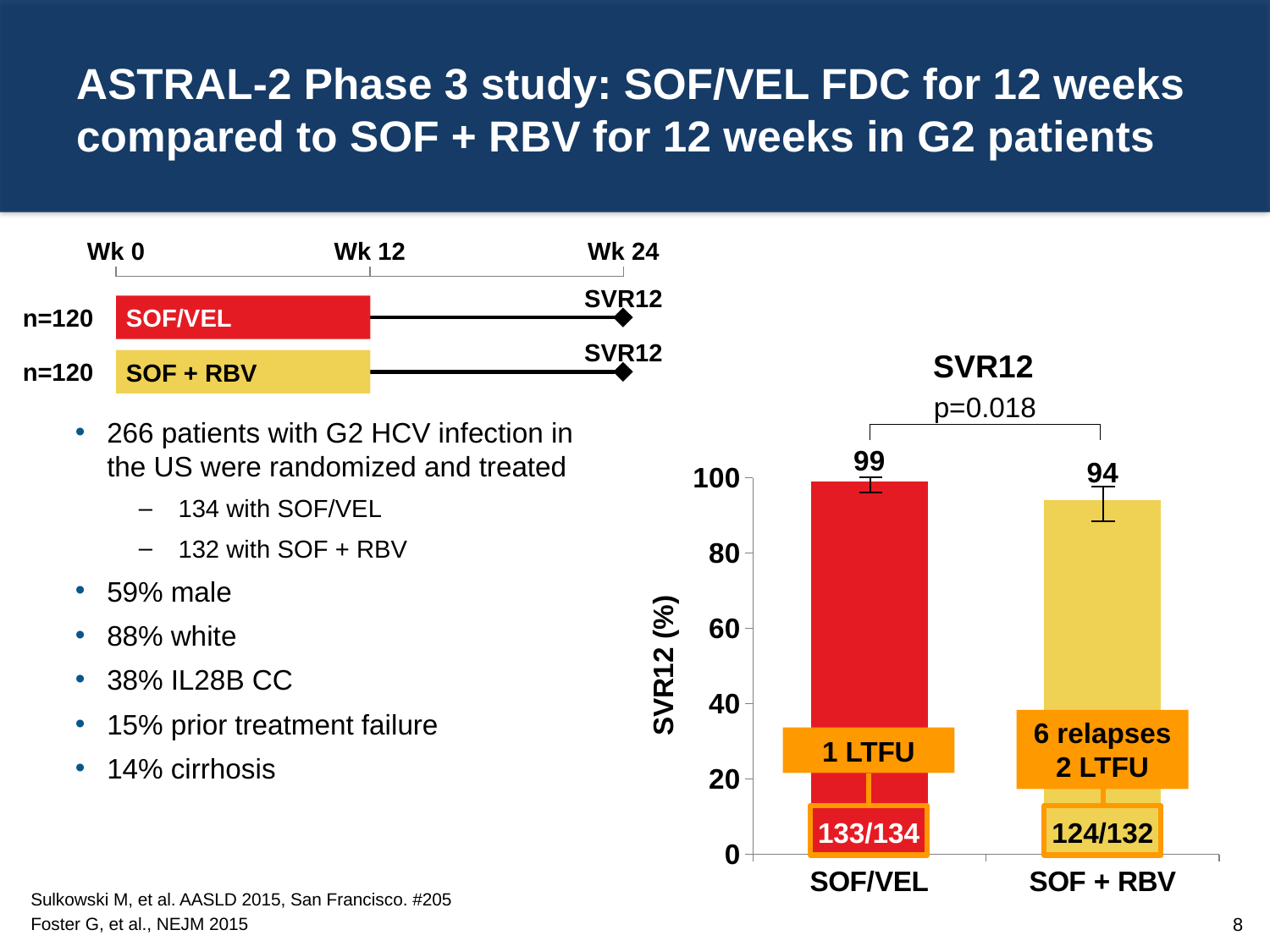
What is the SVR12 value for SOF + RBV? 94 What is the y-axis label of the chart? SVR12 (%) What kind of chart is shown on the slide? Bar chart Which treatment arm has the higher SVR12? SOF/VEL What is the difference in SVR12 between SOF/VEL and SOF + RBV? 5 Which treatment arm has the lower SVR12? SOF + RBV What is the SVR12 value for SOF/VEL? 99 What fraction of patients achieved SVR12 in the SOF + RBV arm? 124/132 What is the title of the chart? SVR12 Is the SVR12 for SOF + RBV greater or less than 80? greater What fraction of patients achieved SVR12 in the SOF/VEL arm? 133/134 How many treatment arms are shown in the chart? 2